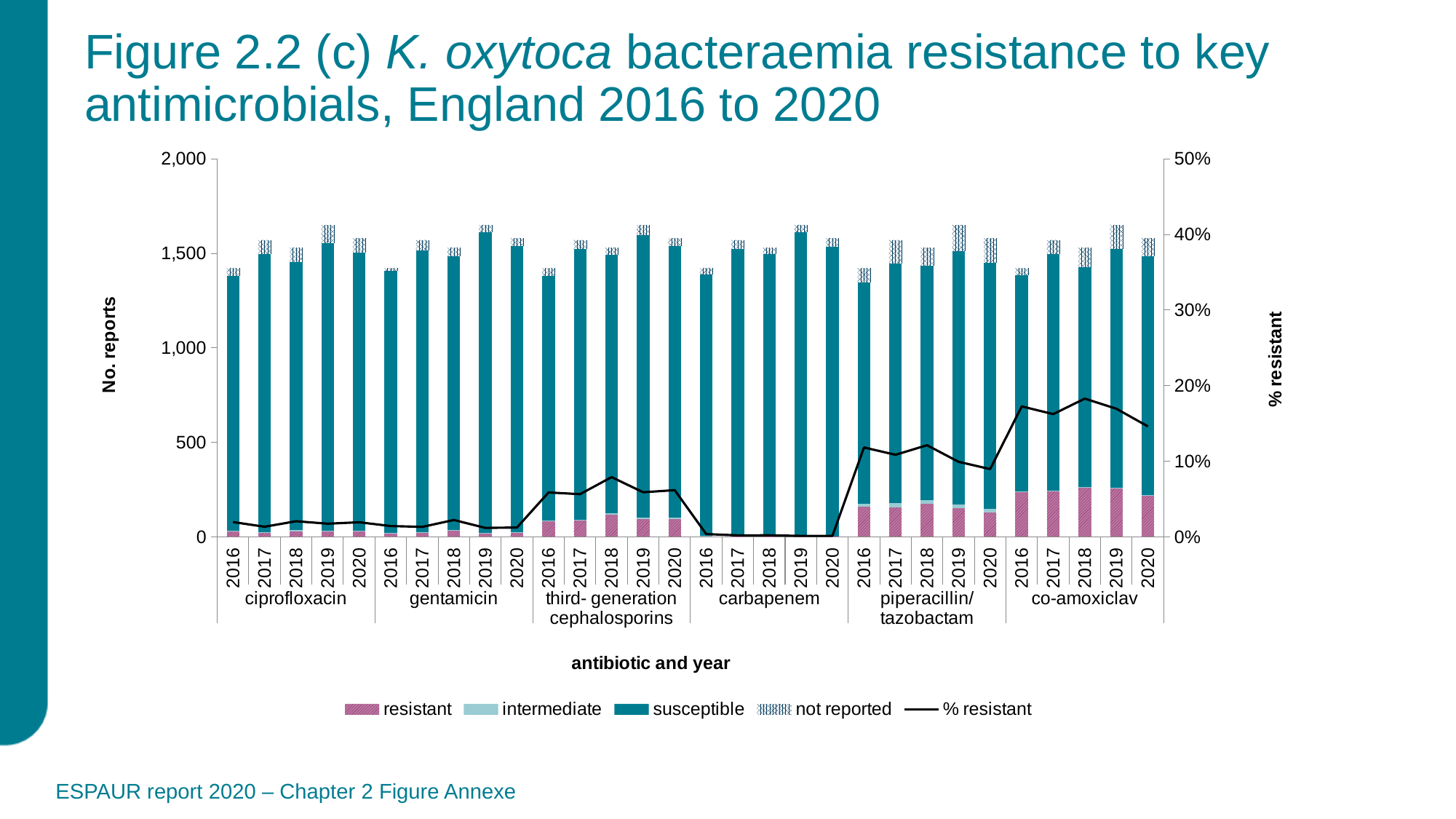
Is the % resistant value for co-amoxiclav in 2018 greater or less than 10%? greater How many antibiotic groups are shown along the x axis? 6 Is the % resistant value for carbapenem in 2019 greater or less than 5%? less Which has the larger % resistant value in 2016: piperacillin/tazobactam or third-generation cephalosporins? piperacillin/tazobactam Which antibiotic has the lowest % resistant values across the years shown? carbapenem Which antibiotic has the highest % resistant values across the years shown? co-amoxiclav What is the title of the left-hand vertical axis? No. reports How many bars are plotted in total on the chart? 30 How many series does the legend list? 5 What kind of chart is shown on the slide? A stacked bar chart with a line overlay Is the total number of reports for gentamicin in 2019 greater or less than 1,500? greater Does the % resistant line for co-amoxiclav rise or fall from 2018 to 2020? fall